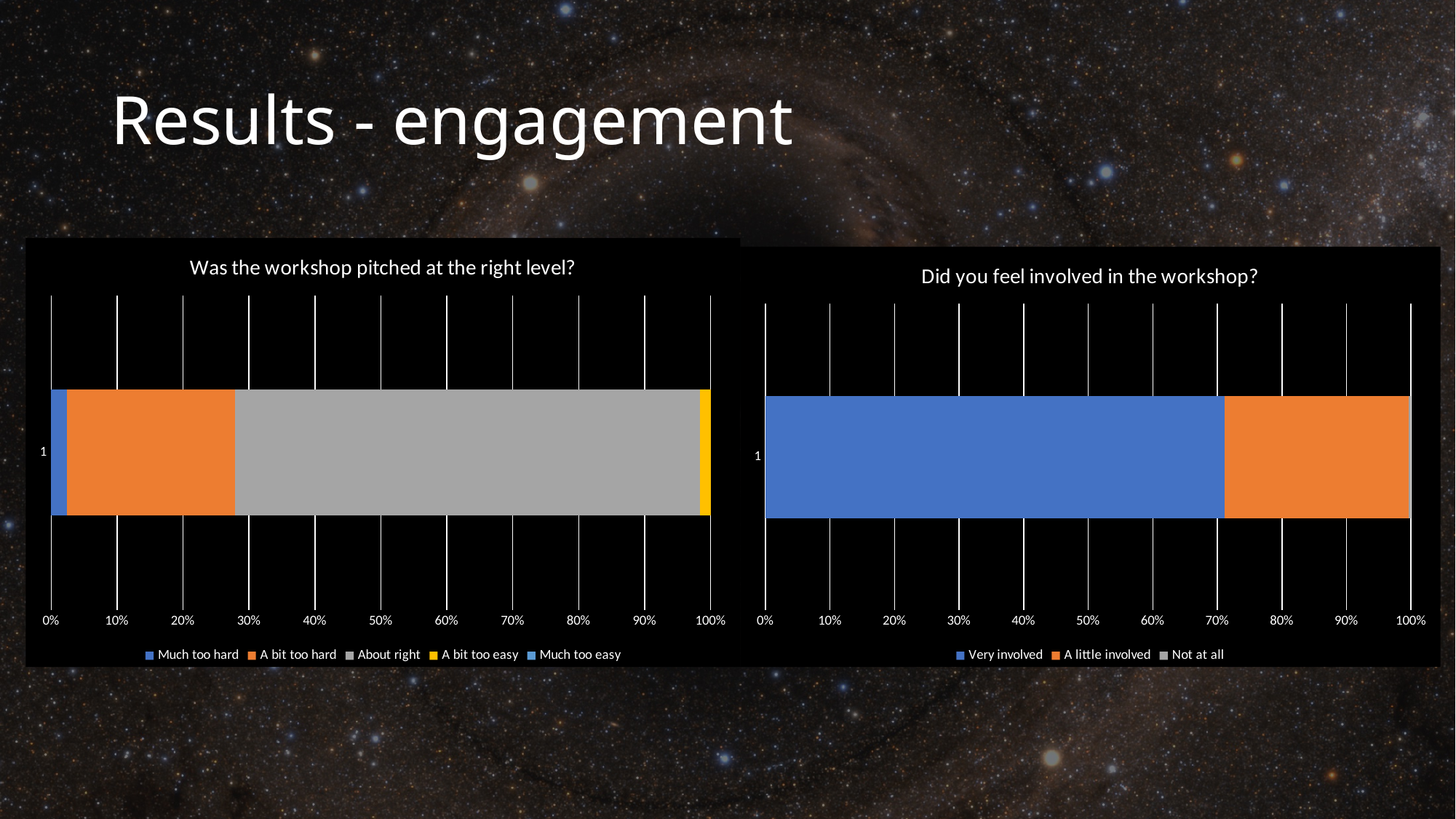
In 'Was the workshop pitched at the right level?', which is larger: the share for 'About right' or for 'A bit too hard'? About right In 'Did you feel involved in the workshop?', is the share for 'A little involved' greater or less than 40%? less In 'Did you feel involved in the workshop?', which legend entry is shown in orange? A little involved In 'Was the workshop pitched at the right level?', is the share for 'About right' greater or less than 50%? greater In 'Was the workshop pitched at the right level?', is the share for 'A bit too hard' greater or less than 30%? less In 'Did you feel involved in the workshop?', which response takes up the largest share of the bar? Very involved What kind of chart is 'Was the workshop pitched at the right level?'? stacked bar chart How many series does the legend of 'Did you feel involved in the workshop?' list? 3 How many series does the legend of 'Was the workshop pitched at the right level?' list? 5 In 'Was the workshop pitched at the right level?', which response takes up the largest share of the bar? About right What kind of chart is 'Did you feel involved in the workshop?'? stacked bar chart